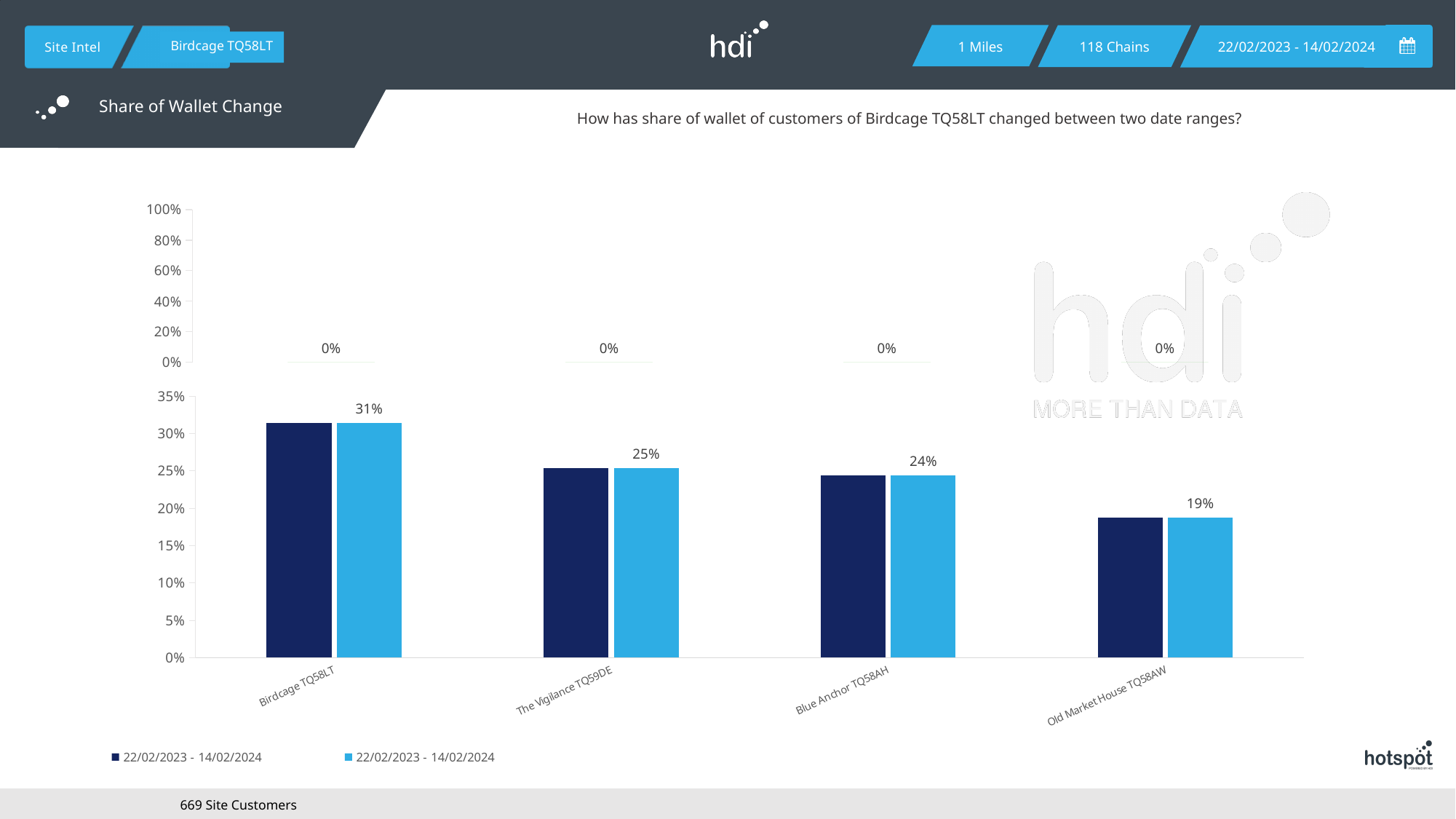
On the bottom chart, what is the share of wallet value labelled for Birdcage TQ58LT? 31% How many series does the legend of the bottom chart list? 2 On the bottom chart, which category has the lowest share of wallet? Old Market House TQ58AW What kind of chart is the bottom chart? Bar chart On the bottom chart, what is the share of wallet value labelled for The Vigilance TQ59DE? 25% On the bottom chart, which is larger: the labelled value for The Vigilance TQ59DE or for Old Market House TQ58AW? The Vigilance TQ59DE On the bottom chart, which category has the highest share of wallet? Birdcage TQ58LT On the bottom chart, what is the share of wallet value labelled for Blue Anchor TQ58AH? 24% How many categories are shown on the x axis of the bottom chart? 4 On the bottom chart, what is the difference between the labelled values for Birdcage TQ58LT and Old Market House TQ58AW? 12% On the bottom chart, what is the share of wallet value labelled for Old Market House TQ58AW? 19% On the top chart, what change value is labelled for Blue Anchor TQ58AH? 0%